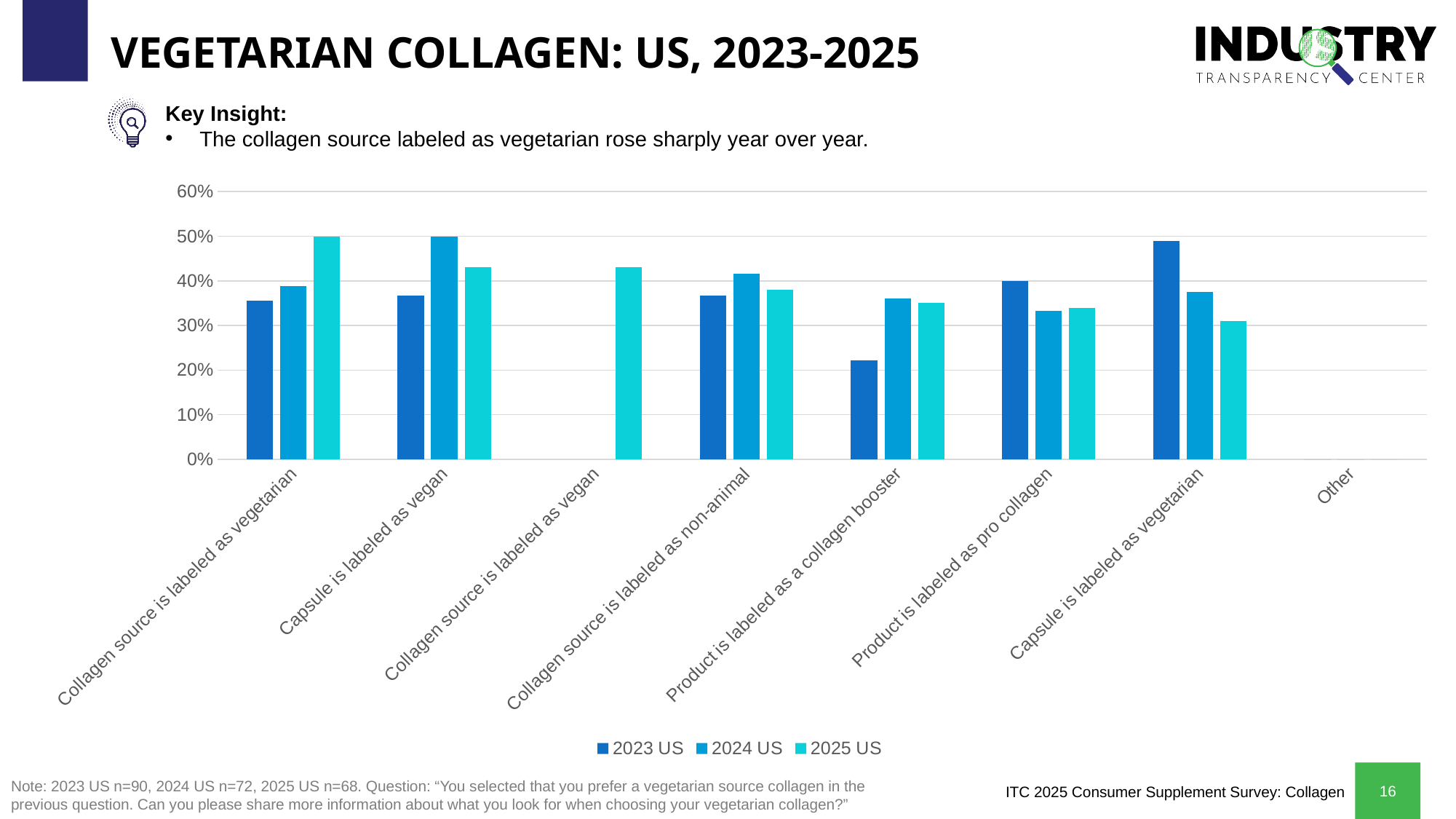
How many categories are shown on the x axis of the chart? 8 For "Capsule is labeled as vegan", which is larger: the 2023 US value or the 2024 US value? 2024 US For "Capsule is labeled as vegetarian", which is larger: the 2023 US value or the 2025 US value? 2023 US How many series does the legend list? 3 What are the three series listed in the chart legend? 2023 US, 2024 US, 2025 US Is the 2023 US value for "Product is labeled as a collagen booster" greater or less than 30%? less Among the 2023 US bars, which category has the lowest value? Product is labeled as a collagen booster What kind of chart is shown on the slide? Bar chart Is the 2025 US value for "Capsule is labeled as vegetarian" greater or less than 40%? less Is the 2025 US value for "Collagen source is labeled as vegetarian" greater or less than 40%? greater For "Capsule is labeled as vegetarian", do the values rise or fall from 2023 US to 2025 US? fall For "Collagen source is labeled as vegetarian", do the values rise or fall from 2023 US to 2025 US? rise